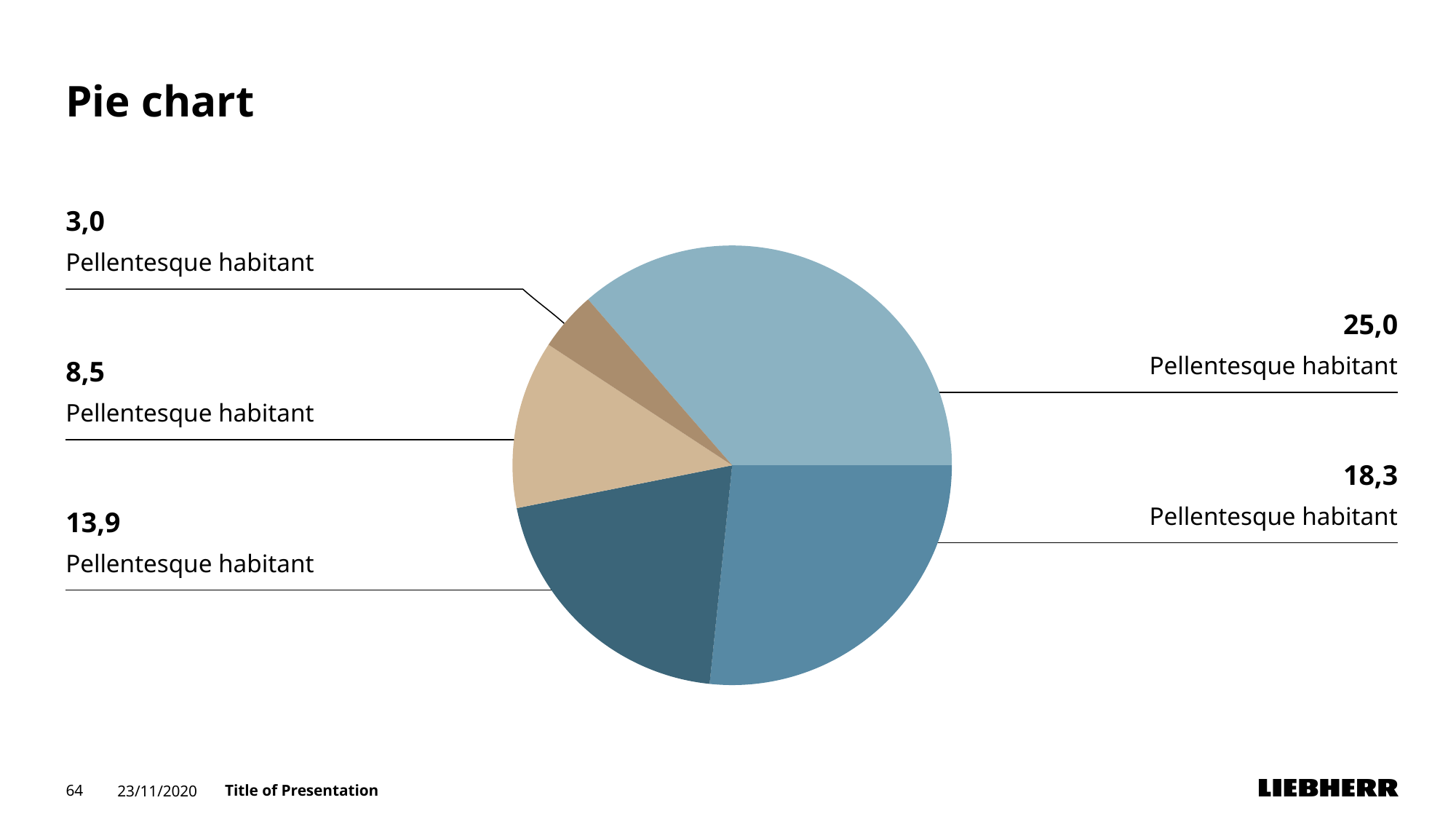
What is the sum of all the slice values shown on the pie chart? 68,7 What kind of chart is shown on the slide? pie chart How many slices does the pie chart have? 5 What is the largest value shown on the pie chart? 25,0 What is the title of the slide containing the pie chart? Pie chart What is the difference between the 13,9 slice and the 8,5 slice? 5,4 What is the difference between the largest slice (25,0) and the second largest slice (18,3)? 6,7 Which is larger, the slice labelled 18,3 or the slice labelled 13,9? 18,3 What is the value of the small dark brown slice at the upper left of the pie chart? 3,0 What is the value of the dark teal slice at the bottom left of the pie chart? 13,9 What is the smallest value shown on the pie chart? 3,0 What is the value of the light blue slice at the top of the pie chart? 25,0